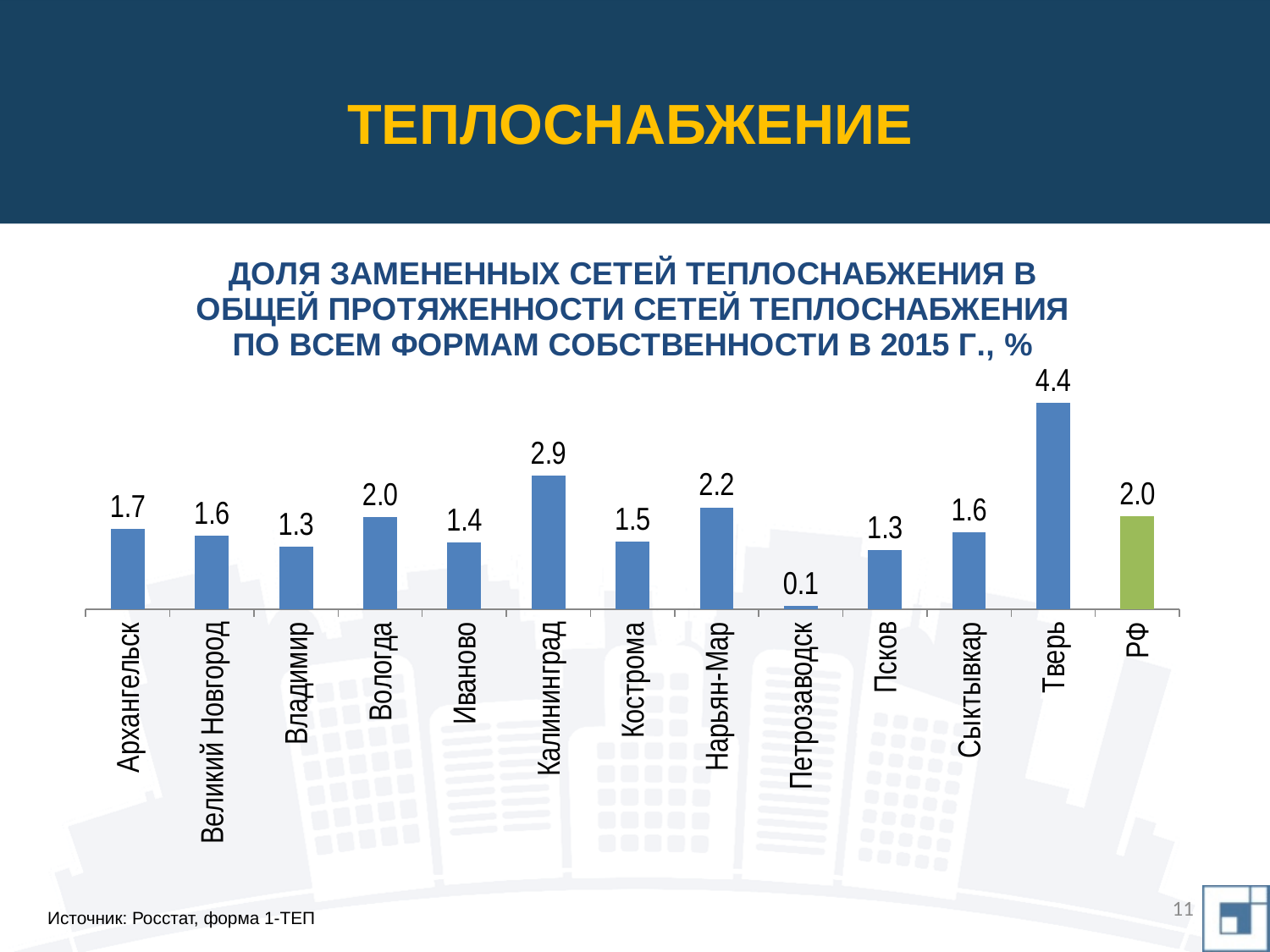
Which category has the lowest value? Петрозаводск What is the value for Тверь? 4.4 What is the value for РФ? 2.0 What is the difference between the values for Вологда and Владимир? 0.7 What is the value for Петрозаводск? 0.1 What is the value for Калининград? 2.9 What kind of chart is shown on the slide? bar chart What is the difference between the values for Тверь and Калининград? 1.5 How many categories are shown on the chart? 13 Which bar is shown in a different colour (green) from the others? РФ Which is larger, the value for Нарьян-Мар or the value for Архангельск? Нарьян-Мар Which category has the highest value? Тверь